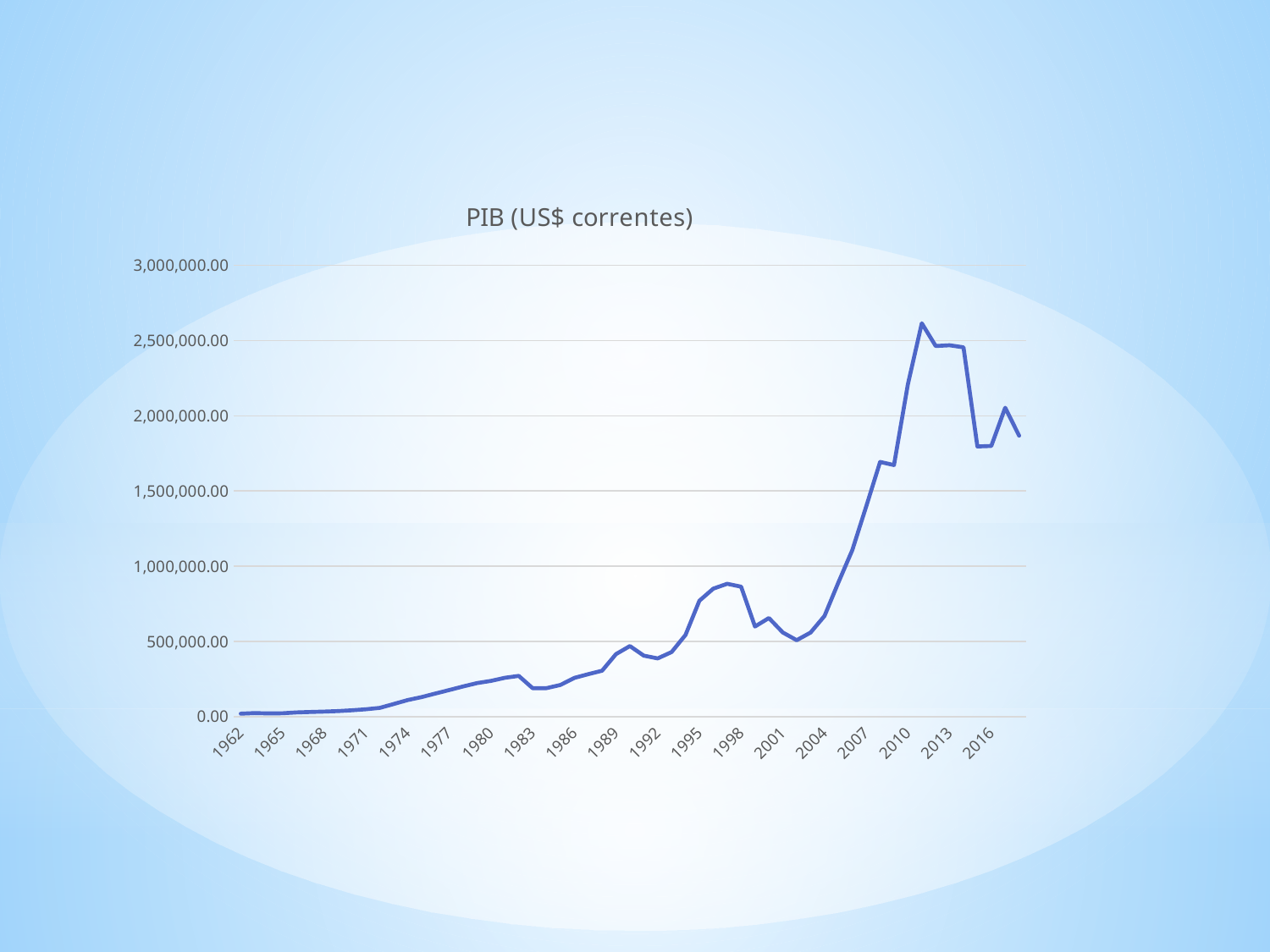
Which year has the highest value on the chart? 2011 Is the value for 1962 greater or less than 500,000.00? less Is the value for 2016 greater or less than 2,000,000.00? less Which is larger, the value for 2011 or the value for 2016? 2011 Which is larger, the value for 1995 or the value for 1983? 1995 Is the value for 2011 greater or less than 2,500,000.00? greater Overall, do the values rise or fall from 1962 to 2011? rise What is the title of the chart? PIB (US$ correntes) What kind of chart is shown on the slide? line chart What is the first year shown on the x axis of the chart? 1962